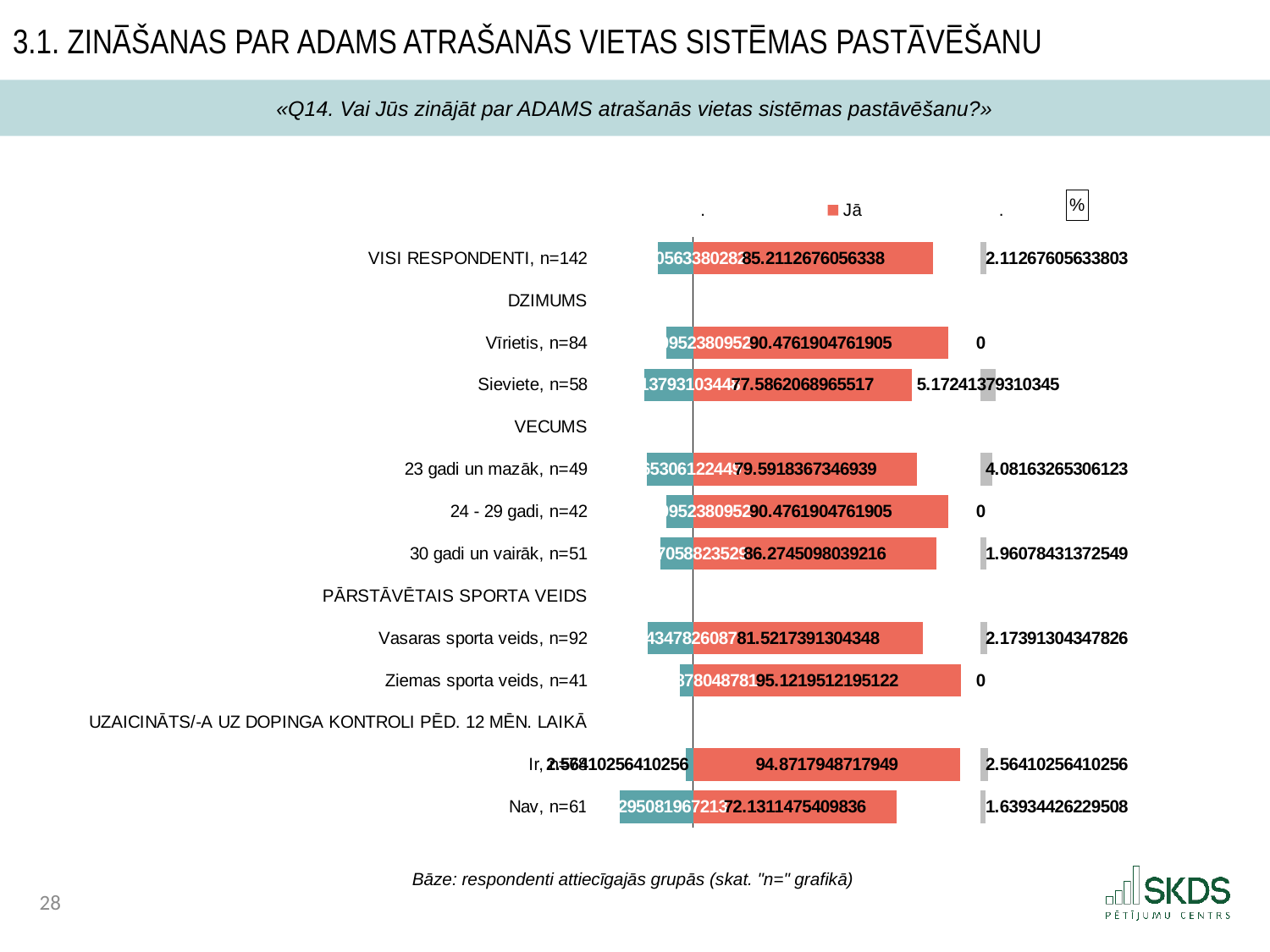
Which series name is readable in the chart legend? Jā What is the "Jā" value for VISI RESPONDENTI, n=142? 85.2112676056338 Which group has the lowest "Jā" value? Nav, n=61 What is the difference between the "Jā" values for Vīrietis, n=84 and Sieviete, n=58? 12.8899835796388 Which group has the highest "Jā" value? Ziemas sporta veids, n=41 What is the "Jā" value for Nav, n=61? 72.1311475409836 What is the "Jā" value for Ziemas sporta veids, n=41? 95.1219512195122 What kind of chart is shown on the slide? Bar chart What is the "Jā" value for Sieviete, n=58? 77.5862068965517 Which has a larger "Jā" value: 23 gadi un mazāk, n=49 or 24 - 29 gadi, n=42? 24 - 29 gadi, n=42 What value is printed at the right end of the row for Sieviete, n=58, after the "Jā" bar? 5.17241379310345 How many respondent groups (rows with n=) have bars plotted in the chart? 10